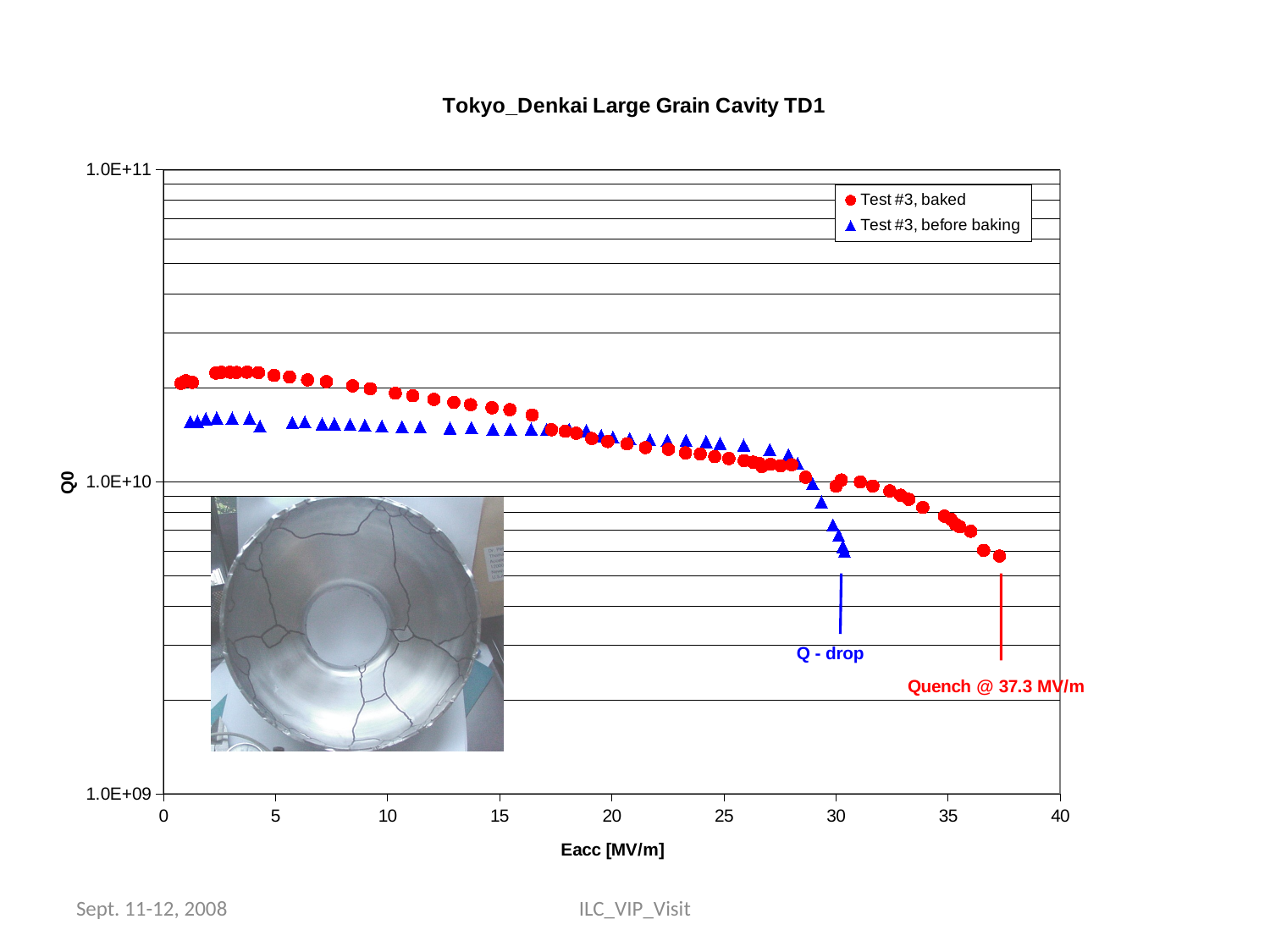
At what accelerating field does the annotation say the quench occurred? 37.3 MV/m What is the highest value shown on the x axis? 40 What is the label of the x axis? Eacc [MV/m] Does Q0 for the 'Test #3, baked' series rise or fall as Eacc increases from 20 to 37 MV/m? fall At 5 MV/m, which series has the higher Q0: 'Test #3, baked' or 'Test #3, before baking'? Test #3, baked Is the Q0 value for the 'Test #3, before baking' series at 30 MV/m greater or less than 1.0E+10? less Is the Q0 value for the 'Test #3, baked' series at 37 MV/m greater or less than 1.0E+10? less What is the title of the chart? Tokyo_Denkai Large Grain Cavity TD1 How many series does the legend list? 2 Which series reaches the higher maximum Eacc value? Test #3, baked Is the Q0 value for the 'Test #3, baked' series at 5 MV/m greater or less than 1.0E+10? greater What kind of chart is shown on the slide? scatter chart